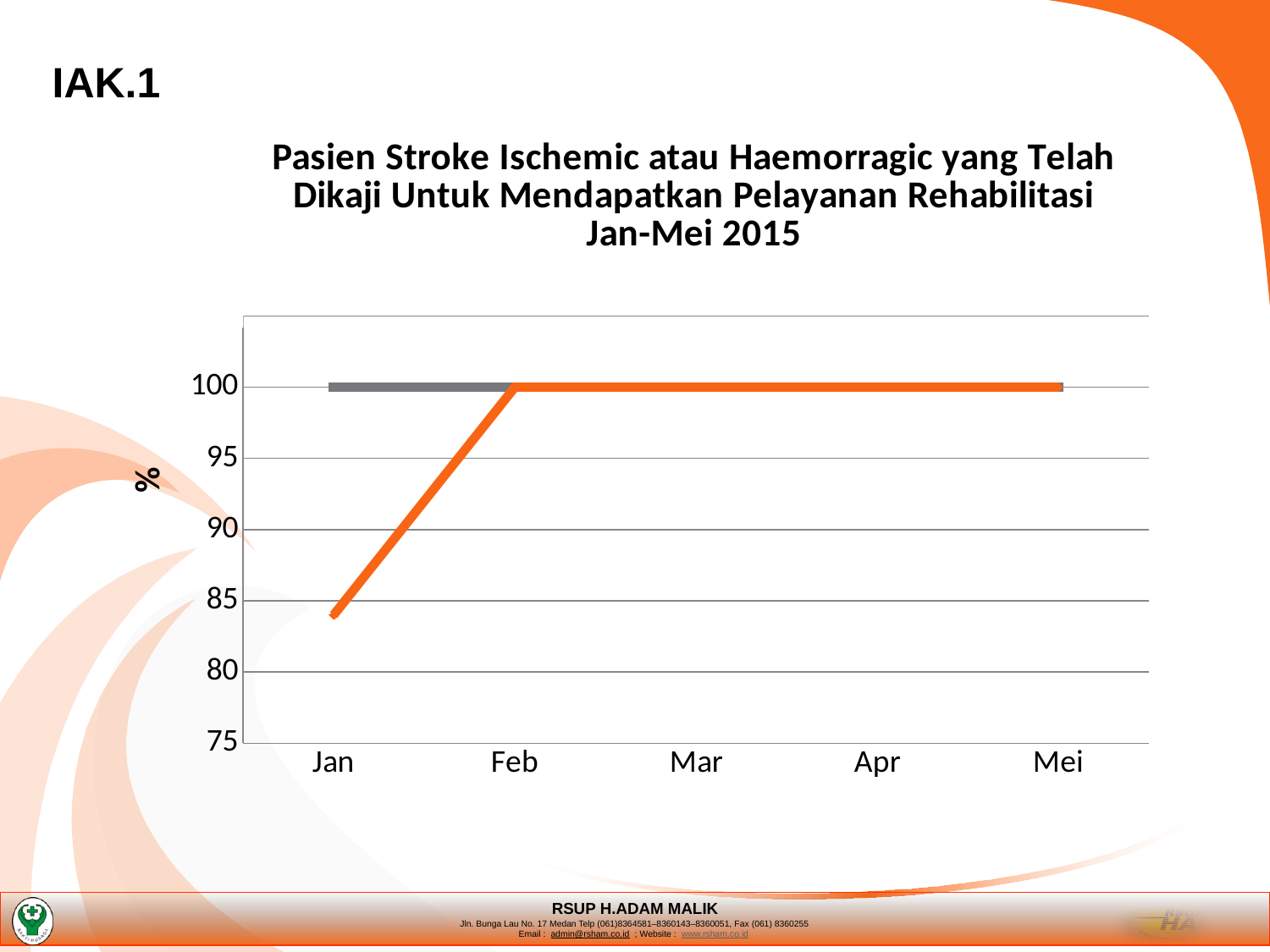
Is the value for Apr on the orange line greater or less than 95? greater Which is larger, the value for Jan or the value for Mar on the orange line? Mar What label is shown on the y axis of the chart? % What is the value for Mei on the orange line? 100 How does the orange line change from Jan to Feb? It rises What is the value for Feb on the orange line? 100 How does the orange line change from Feb to Mei? It stays flat at 100 What kind of chart is shown on the slide? line chart Which month has the lowest value on the orange line? Jan How many months are shown on the x axis of the chart? 5 What period does the chart title say the data covers? Jan-Mei 2015 Is the value for Jan on the orange line greater or less than 90? less